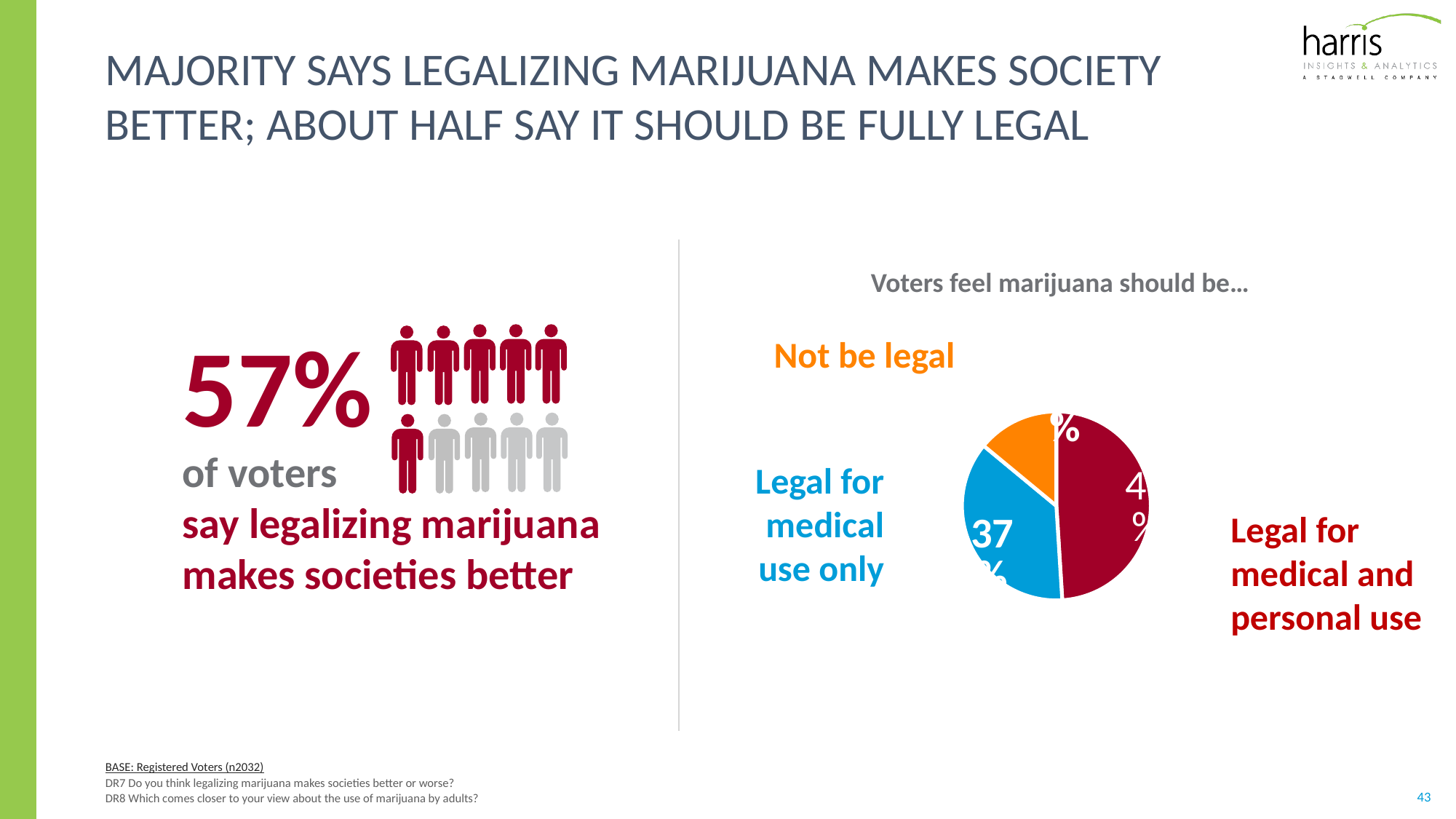
In the pie chart, which option has the largest slice? Legal for medical and personal use In the pie chart, what percentage of voters feel marijuana should be legal for medical use only? 37% In the pie chart, which option has the smallest slice? Not be legal How many slices does the pie chart have? 3 What kind of chart is shown under the heading "Voters feel marijuana should be…"? pie chart What share of the pie does the "Legal for medical use only" slice represent? 37% According to the pictogram on the left, what percentage of voters say legalizing marijuana makes societies better? 57% What colour is the "Not be legal" slice in the pie chart? orange In the pie chart, which slice is larger: "Legal for medical use only" or "Legal for medical and personal use"? Legal for medical and personal use What is the heading above the pie chart? Voters feel marijuana should be… In the pie chart, which slice is larger: "Not be legal" or "Legal for medical use only"? Legal for medical use only